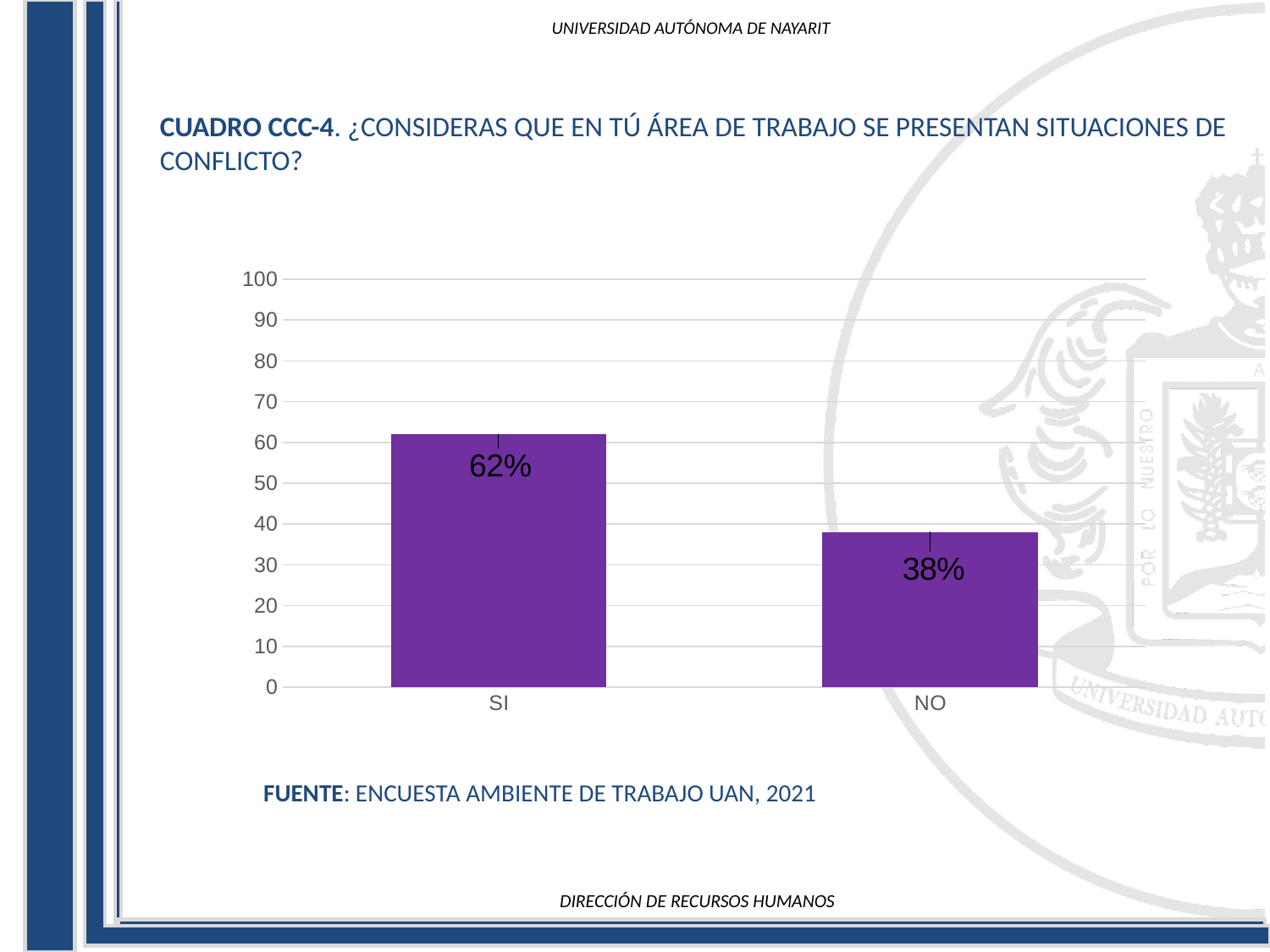
Is the value for NO greater or less than 40? less Which category has the highest value? SI How many categories are shown on the x axis? 2 What source is cited below the chart? ENCUESTA AMBIENTE DE TRABAJO UAN, 2021 Which category has the lowest value? NO What is the value for SI? 62% Which is larger, the value for SI or the value for NO? SI What is the highest value shown on the y axis? 100 What is the value for NO? 38% Is the value for SI greater or less than 50? greater What is the difference between the values for SI and NO? 24% What kind of chart is shown on the slide? bar chart